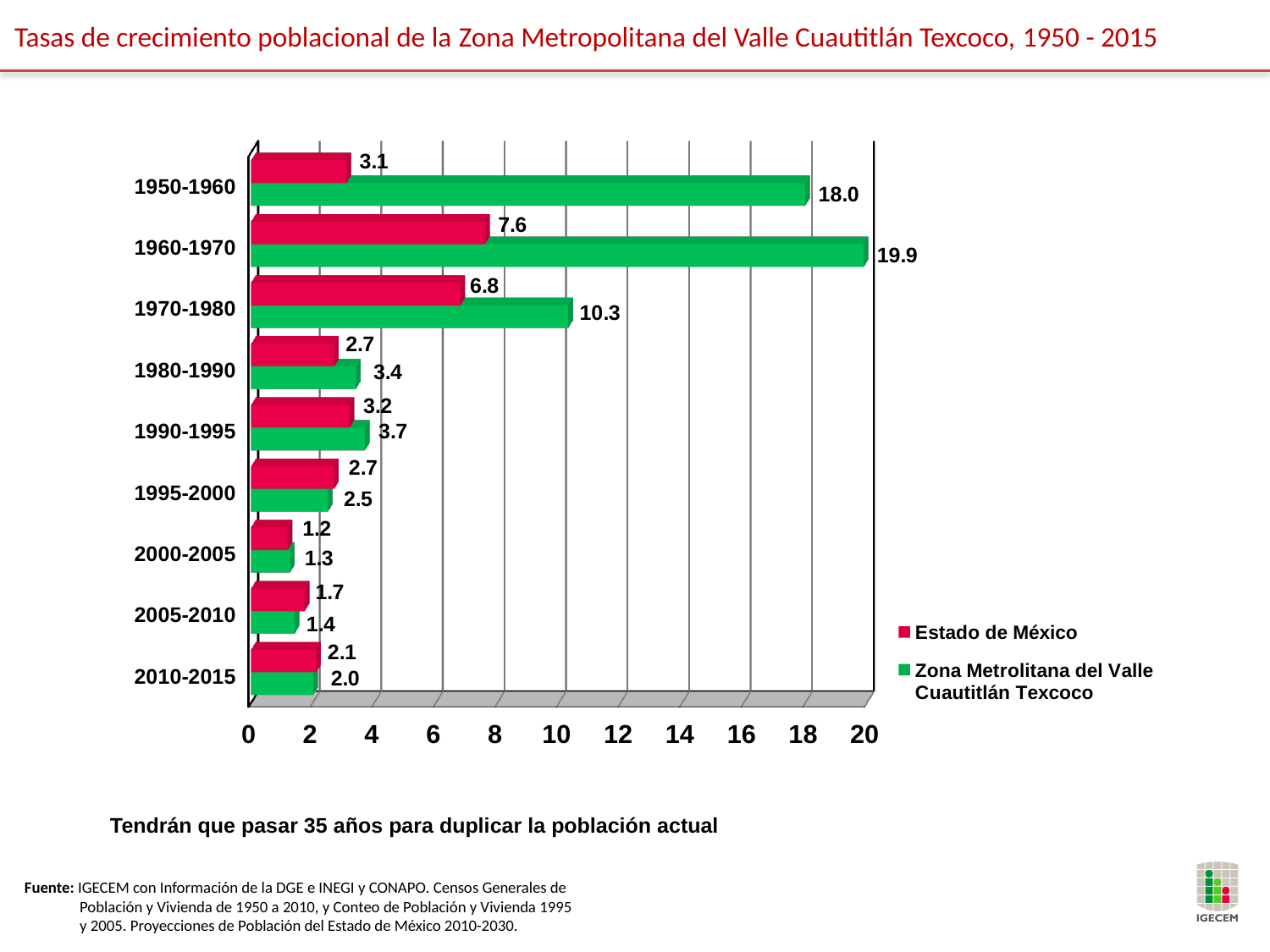
What is the value for Estado de México in 1960-1970? 7.6 Which colour represents Estado de México in the chart? red Is the value for Zona Metrolitana del Valle Cuautitlán Texcoco in 1960-1970 greater or less than 18? greater How many periods are shown on the chart? 9 What is the value for Zona Metrolitana del Valle Cuautitlán Texcoco in 2010-2015? 2.0 Which period has the lowest value for Estado de México? 2000-2005 How many series does the legend list? 2 Which period has the highest value for Zona Metrolitana del Valle Cuautitlán Texcoco? 1960-1970 What is the difference between the Zona Metrolitana del Valle Cuautitlán Texcoco value and the Estado de México value in 1950-1960? 14.9 In 2005-2010, which series has the larger value, Estado de México or Zona Metrolitana del Valle Cuautitlán Texcoco? Estado de México What kind of chart is shown on the slide? bar chart What is the value for Zona Metrolitana del Valle Cuautitlán Texcoco in 1970-1980? 10.3